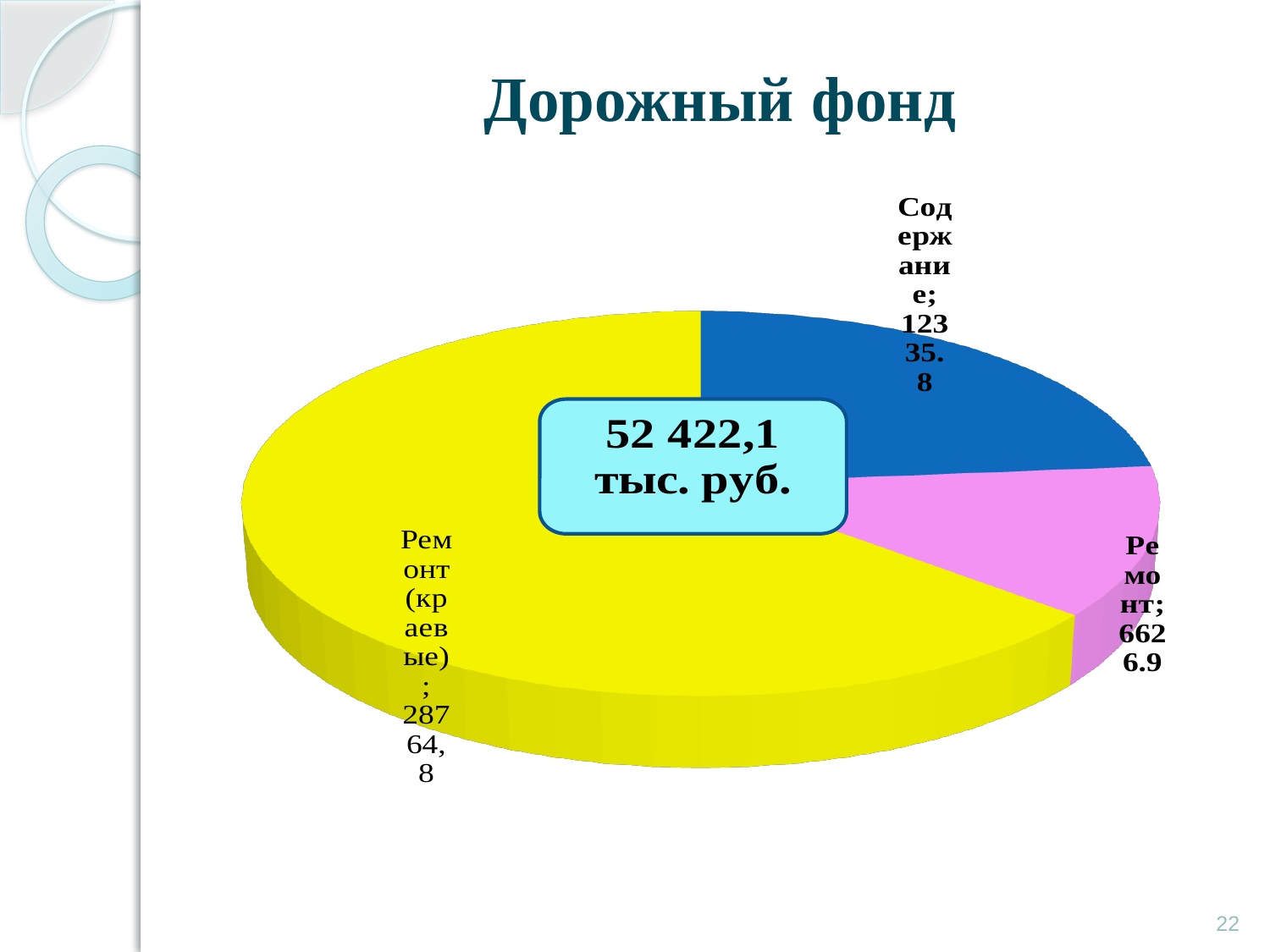
What colour is the Ремонт (краевые) slice? yellow Which slice of the pie chart is the largest? Ремонт (краевые) What value is shown for the Содержание slice? 12335.8 What kind of chart is shown on the slide? pie chart Which is larger, the value for Содержание or the value for Ремонт? Содержание What is the difference between the Содержание value and the Ремонт value? 5708.9 Which slice of the pie chart is the smallest? Ремонт What value is shown for the Ремонт (краевые) slice? 28764,8 What total amount is written in the box at the centre of the pie chart? 52 422,1 тыс. руб. What is the title of the chart? Дорожный фонд What value is shown for the Ремонт slice? 6626.9 How many slices does the pie chart have? 3